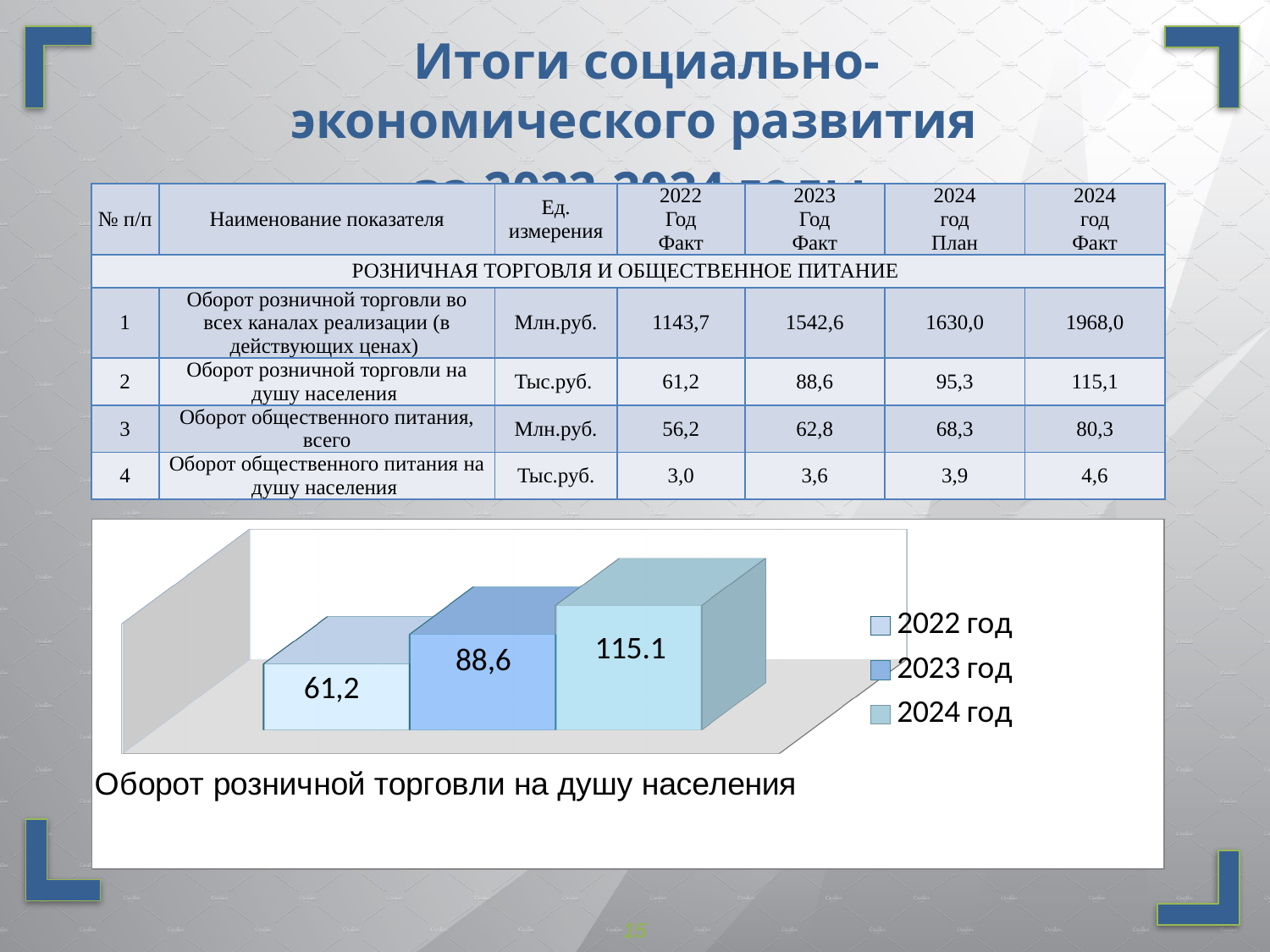
Do the values in the chart rise or fall from 2022 год to 2024 год? Rise What is the value shown for 2023 год in the chart? 88,6 How many bars are plotted in the chart? 3 Which is larger in the chart, the value for 2022 год or the value for 2023 год? 2023 год How many series does the chart legend list? 3 What is the value shown for 2024 год in the chart? 115.1 What kind of chart is shown on the slide? Bar chart What is the value shown for 2022 год in the chart? 61,2 Which year has the lowest value in the chart? 2022 год What is the difference between the values for 2023 год and 2022 год in the chart? 27,4 What is the difference between the values for 2024 год and 2023 год in the chart? 26,5 Which year has the highest value in the chart? 2024 год